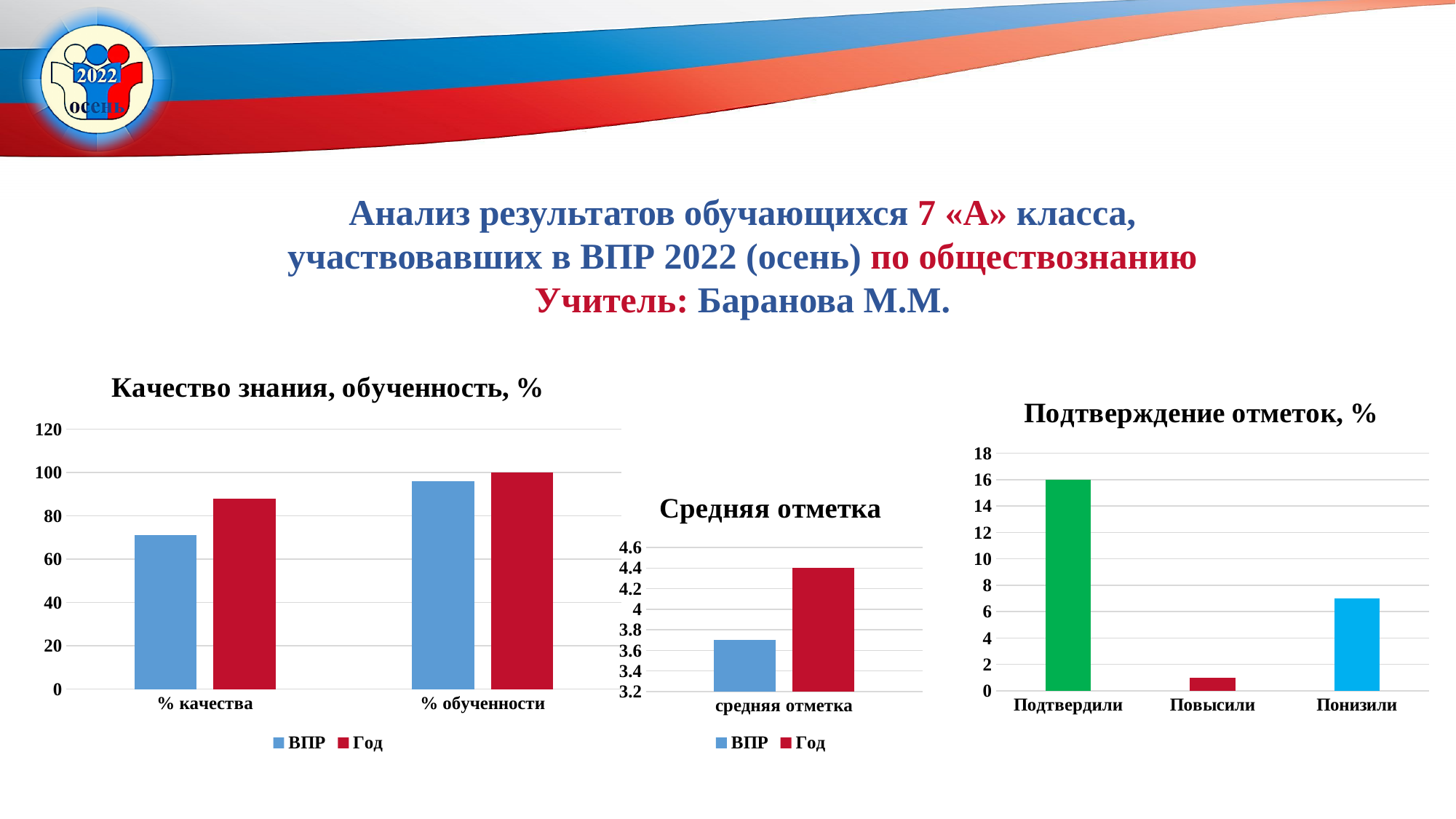
In the chart titled "Подтверждение отметок, %", which category has the highest value? Подтвердили How many categories are shown on the x axis of the chart titled "Подтверждение отметок, %"? 3 In the chart titled "Средняя отметка", is the ВПР value greater or less than 4? less In the chart titled "Подтверждение отметок, %", which category has the lowest value? Повысили In the chart titled "Качество знания, обученность, %", is the Год value for % качества greater or less than 80? greater In the chart titled "Качество знания, обученность, %", what is the value of the Год series for % обученности? 100 In the chart titled "Качество знания, обученность, %", which series has the larger value for % качества, ВПР or Год? Год In the chart titled "Подтверждение отметок, %", what is the value for Подтвердили? 16 In the chart titled "Качество знания, обученность, %", is the ВПР value for % качества greater or less than 80? less In the chart titled "Средняя отметка", which series has the larger value, ВПР or Год? Год How many series does the legend of the chart titled "Качество знания, обученность, %" list? 2 In the chart titled "Средняя отметка", what is the value of the Год series? 4.4